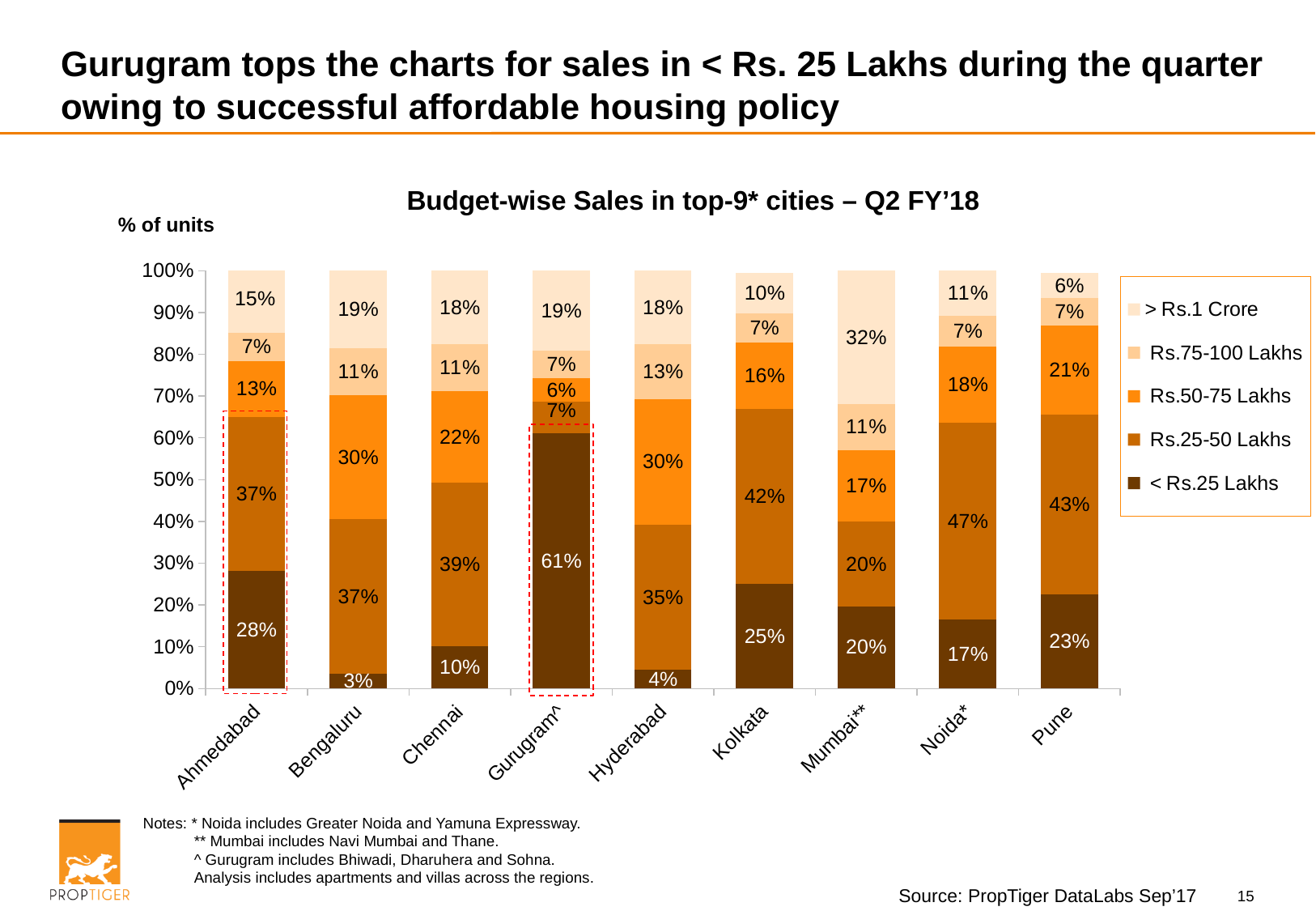
Which city has a larger share in the Rs.50-75 Lakhs segment, Chennai or Pune? Chennai Which city has the highest share of sales in the < Rs.25 Lakhs segment? Gurugram^ What is the difference between the < Rs.25 Lakhs share in Gurugram^ and in Ahmedabad? 33 percentage points Which city has the lowest share of sales in the < Rs.25 Lakhs segment? Bengaluru What is the title of the chart? Budget-wise Sales in top-9* cities – Q2 FY'18 What share of units sold in Gurugram^ were in the < Rs.25 Lakhs budget segment? 61% What share of units sold in Noida* were in the Rs.25-50 Lakhs segment? 47% What type of chart is used on this slide? Stacked bar chart How many budget segments does the legend list? 5 What share of units sold in Mumbai** were in the > Rs.1 Crore segment? 32% How many cities are shown on the x axis of the chart? 9 Which city has the highest share of sales in the > Rs.1 Crore segment? Mumbai**